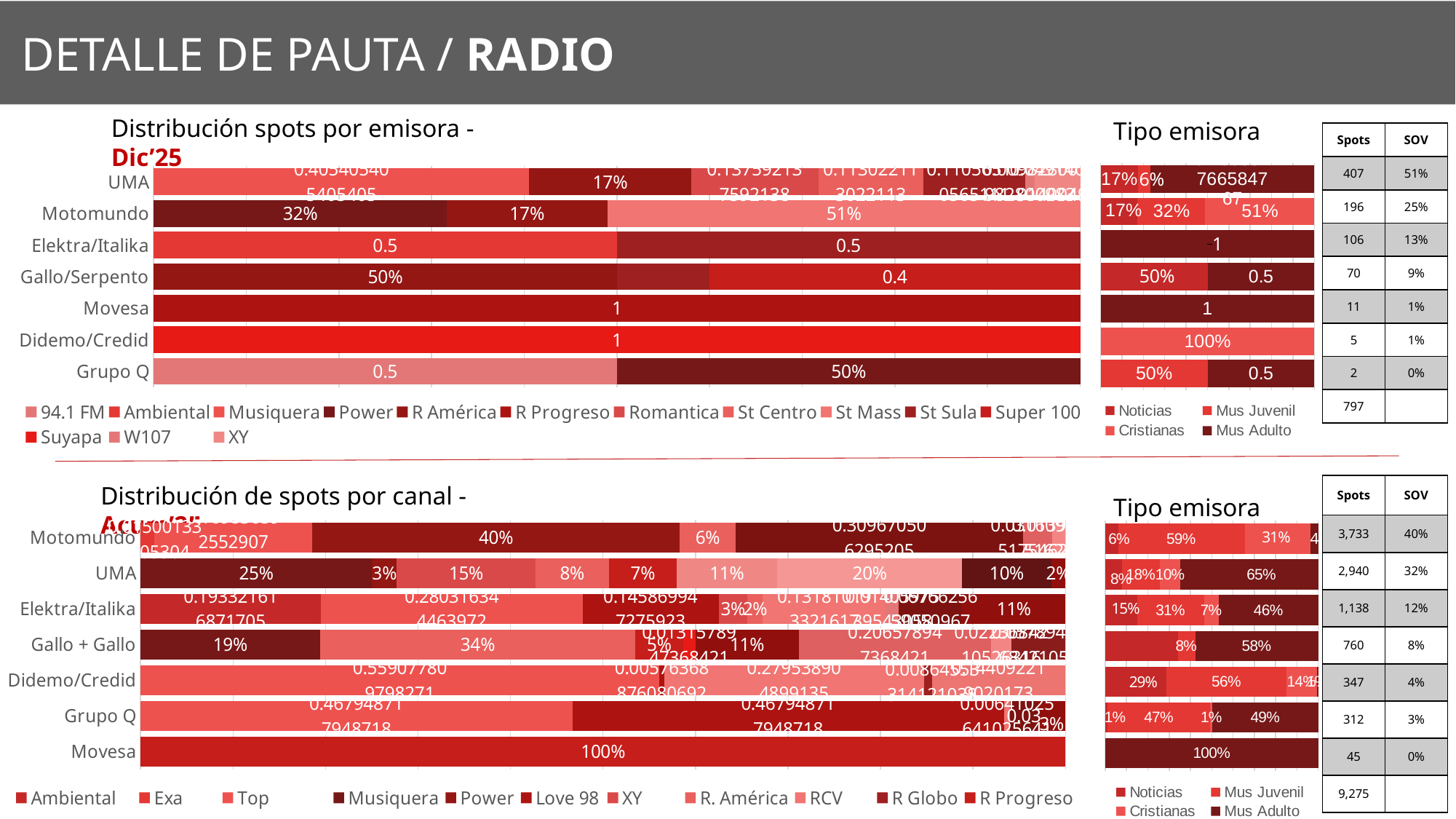
In the bottom-left 'Distribución de spots por canal' chart, what value is labelled on the Movesa bar? 100% In the top-right 'Tipo emisora' chart, what is the smallest segment value shown for Motomundo? 17% How many series does the legend of the top-left 'Distribución spots por emisora - Dic'25' chart list? 14 In the top-left 'Distribución spots por emisora - Dic'25' chart, what is the largest segment value shown for Motomundo? 51% How many emisoras (categories) are shown in the top-left 'Distribución spots por emisora - Dic'25' chart? 7 How many series does the legend of the top-right 'Tipo emisora' chart list? 4 In the bottom-right 'Tipo emisora' chart, what is the largest segment value shown for UMA? 65% In the top-right 'Tipo emisora' chart, what value is labelled on the Didemo/Credid bar? 100% In the top-left 'Distribución spots por emisora - Dic'25' chart, what value is labelled on the Movesa bar? 1 How many series does the legend of the bottom-left 'Distribución de spots por canal' chart list? 11 What kind of chart is the top-left 'Distribución spots por emisora - Dic'25' chart? bar chart In the bottom-left 'Distribución de spots por canal' chart, what is the largest segment value shown for UMA? 25%